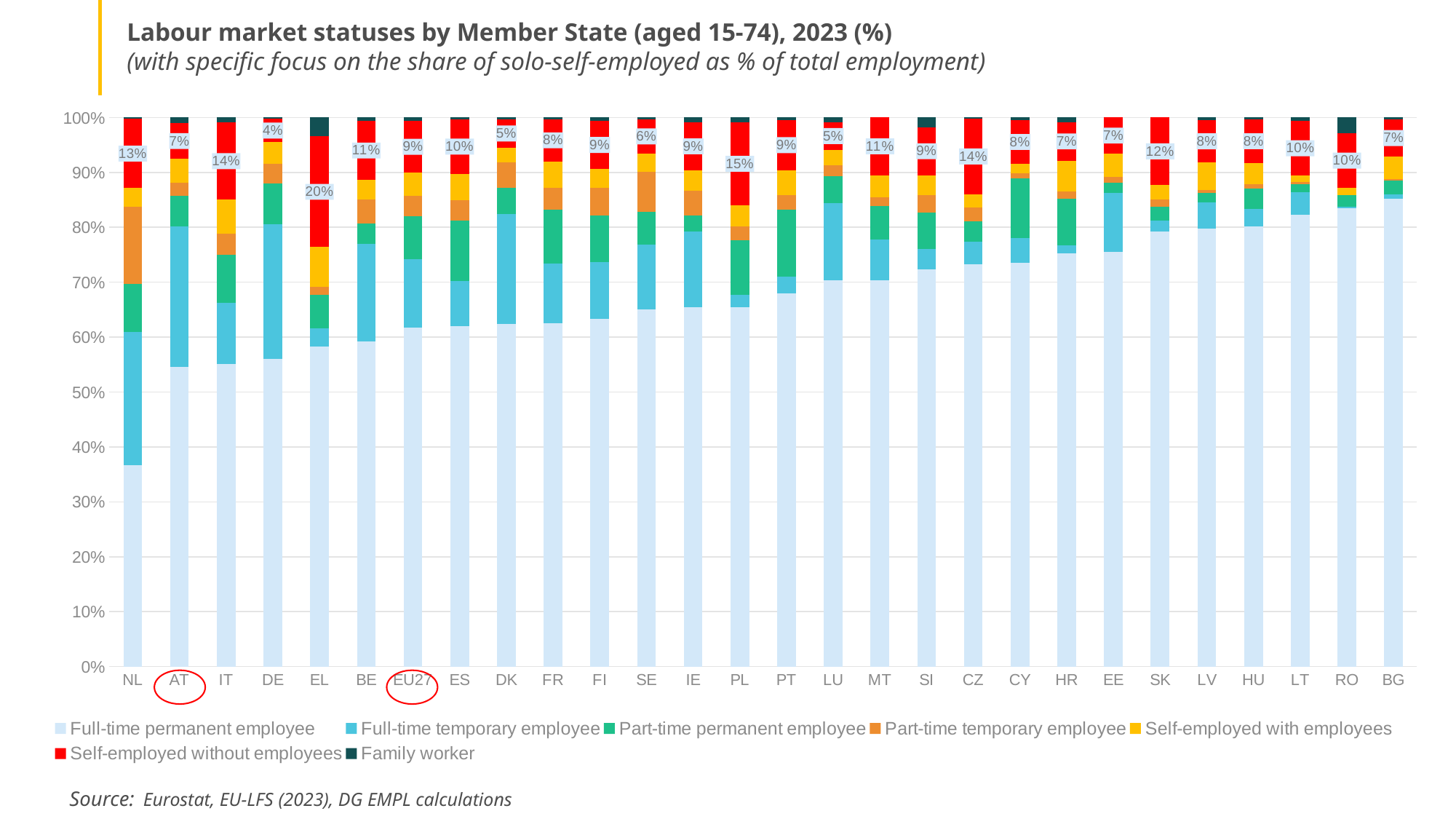
What is the labelled share of solo-self-employed for EU27? 9% What is the labelled share of solo-self-employed for EL? 20% Which has a larger labelled solo-self-employed share, IT or SK? IT Is the Full-time permanent employee share for NL greater or less than 40%? less What is the labelled share of solo-self-employed for AT? 7% How many series does the legend list? 7 What is the difference between the labelled solo-self-employed shares of PL and DK? 10% Which Member State has the highest labelled share of solo-self-employed? EL How many bars (Member States plus EU27) are shown on the x axis? 28 Which Member State has the lowest labelled share of solo-self-employed? DE What kind of chart is shown on the slide? Stacked bar chart Which legend entry is shown in red? Self-employed without employees